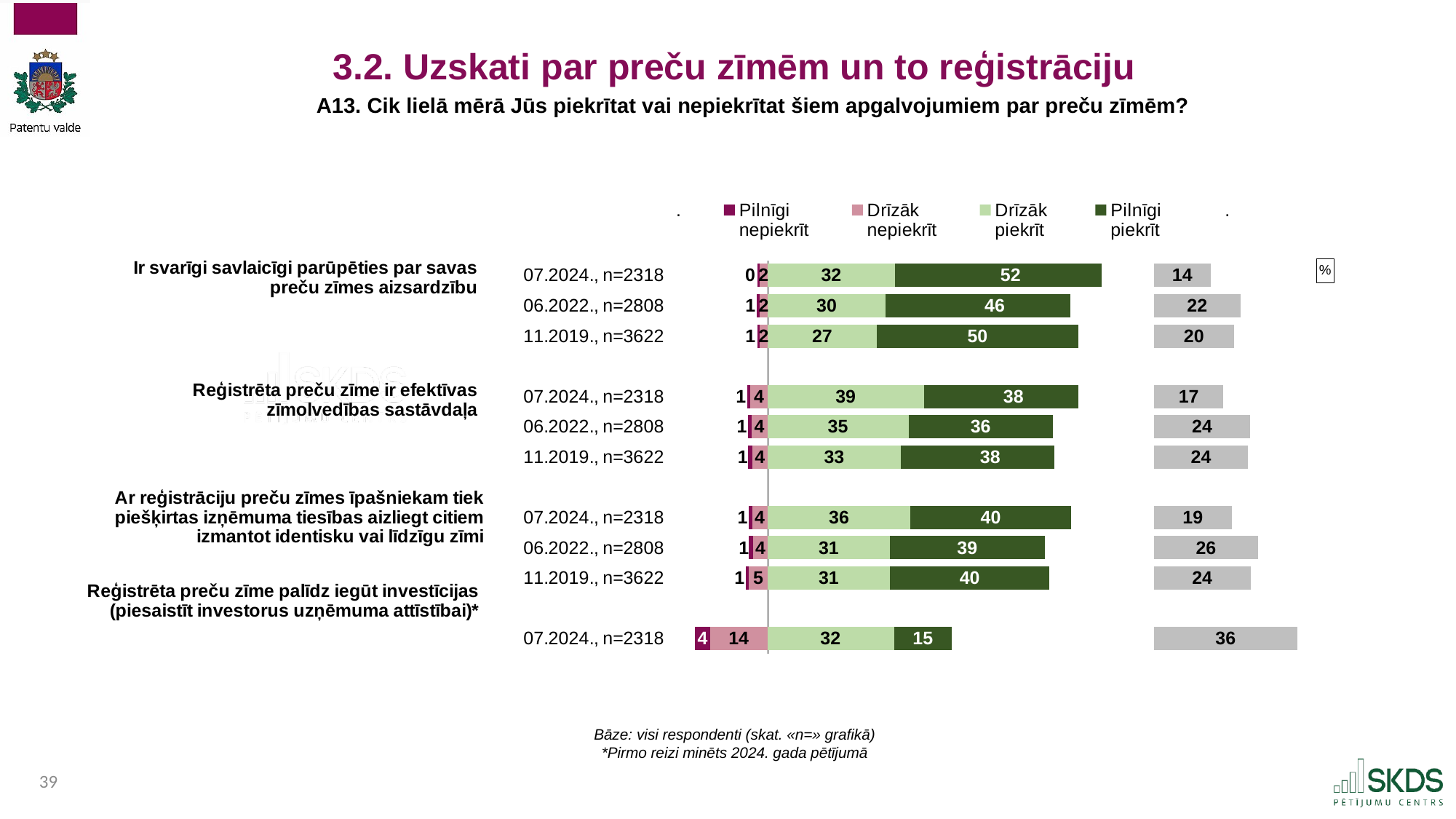
What is the total of the four stacked segments for "Ir svarīgi savlaicīgi parūpēties par savas preču zīmes aizsardzību" in 11.2019 (n=3622)? 80 What is the value of the grey bar on the right for "Reģistrēta preču zīme palīdz iegūt investīcijas" in 07.2024? 36 What is the "Drīzāk nepiekrīt" value for "Reģistrēta preču zīme palīdz iegūt investīcijas" in 07.2024? 14 For "Ir svarīgi savlaicīgi parūpēties par savas preču zīmes aizsardzību", what is the difference in the "Pilnīgi piekrīt" value between 07.2024 and 06.2022? 6 How many series does the legend list? 4 How many survey waves are shown for the statement "Reģistrēta preču zīme ir efektīvas zīmolvedības sastāvdaļa"? 3 Which colour represents "Pilnīgi piekrīt" in the legend? Dark green What percentage of respondents in 07.2024 (n=2318) answered "Pilnīgi piekrīt" to the statement "Ir svarīgi savlaicīgi parūpēties par savas preču zīmes aizsardzību"? 52 Among the 07.2024 results, which statement has the highest "Pilnīgi piekrīt" value? Ir svarīgi savlaicīgi parūpēties par savas preču zīmes aizsardzību For "Ar reģistrāciju preču zīmes īpašniekam tiek piešķirtas izņēmuma tiesības...", which wave has the larger "Drīzāk piekrīt" value: 07.2024 or 06.2022? 07.2024 What kind of chart is shown on the slide? Stacked bar chart What is the "Drīzāk piekrīt" value for "Reģistrēta preču zīme ir efektīvas zīmolvedības sastāvdaļa" in 07.2024 (n=2318)? 39